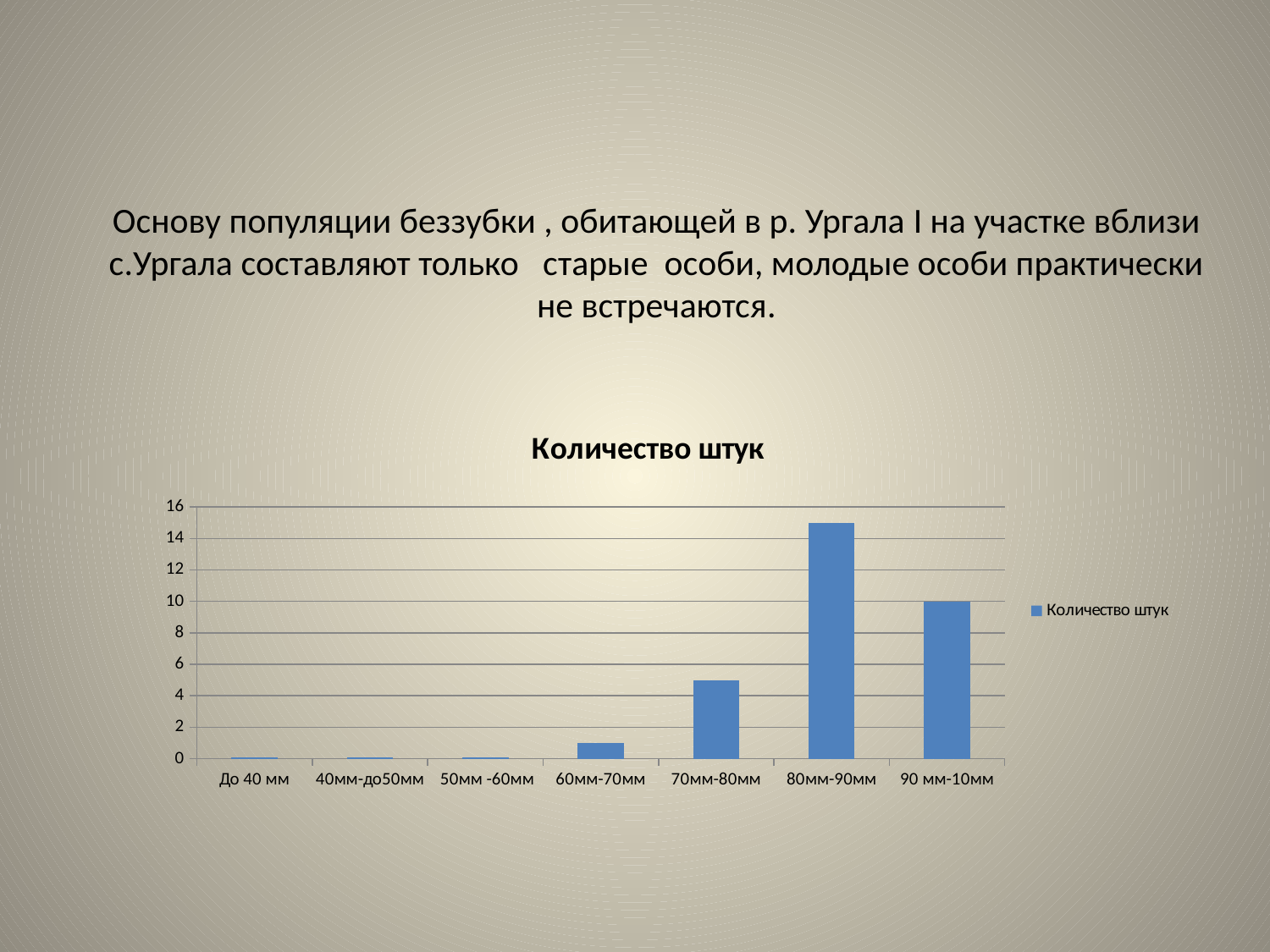
Which is larger, the value for 60мм-70мм or the value for 70мм-80мм? 70мм-80мм How many series does the legend list? 1 Which category has the highest value? 80мм-90мм Is the value for 60мм-70мм greater or less than 2? less Is the value for 80мм-90мм greater or less than 14? greater Which is larger, the value for 80мм-90мм or the value for 90 мм-10мм? 80мм-90мм Is the value for 70мм-80мм greater or less than 4? greater What is the value for 90 мм-10мм? 10 How many categories are shown on the x axis of the chart? 7 What is the title of the chart? Количество штук What type of chart is shown on the slide? bar chart Do the values rise or fall from До 40 мм to 80мм-90мм along the x axis? rise